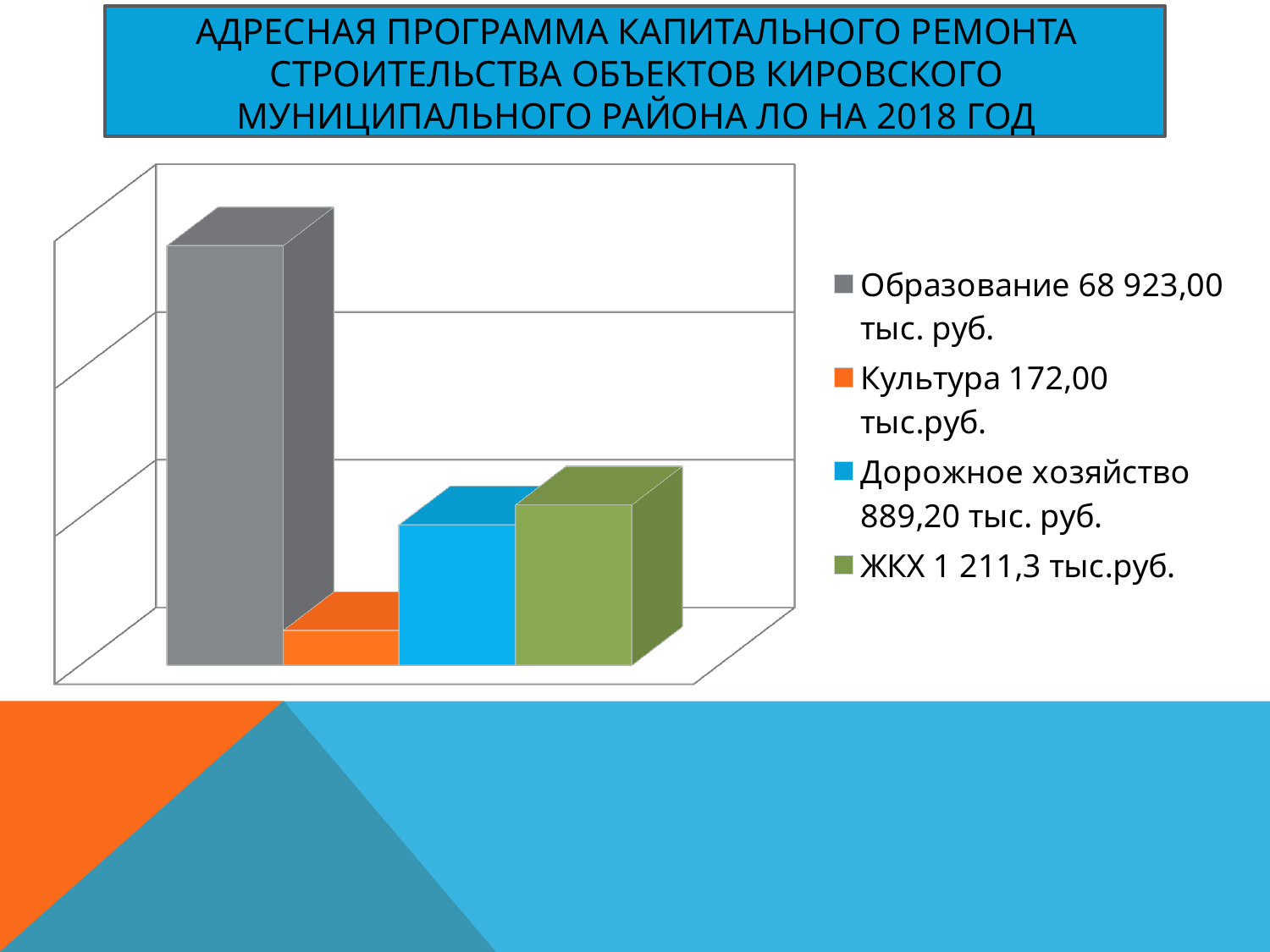
How many bars are plotted in the chart? 4 What value does the legend give for Дорожное хозяйство? 889,20 тыс. руб. Which category has the highest value? Образование How many entries does the legend list? 4 What value does the legend give for Образование? 68 923,00 тыс. руб. What value does the legend give for ЖКХ? 1 211,3 тыс.руб. What colour is the bar for Дорожное хозяйство? Blue What is the difference between the values for Дорожное хозяйство and Культура? 717,20 тыс. руб. What kind of chart is shown on the slide? Bar chart What value does the legend give for Культура? 172,00 тыс.руб. Which category has the lowest value? Культура Which is larger, the value for Дорожное хозяйство or the value for ЖКХ? ЖКХ